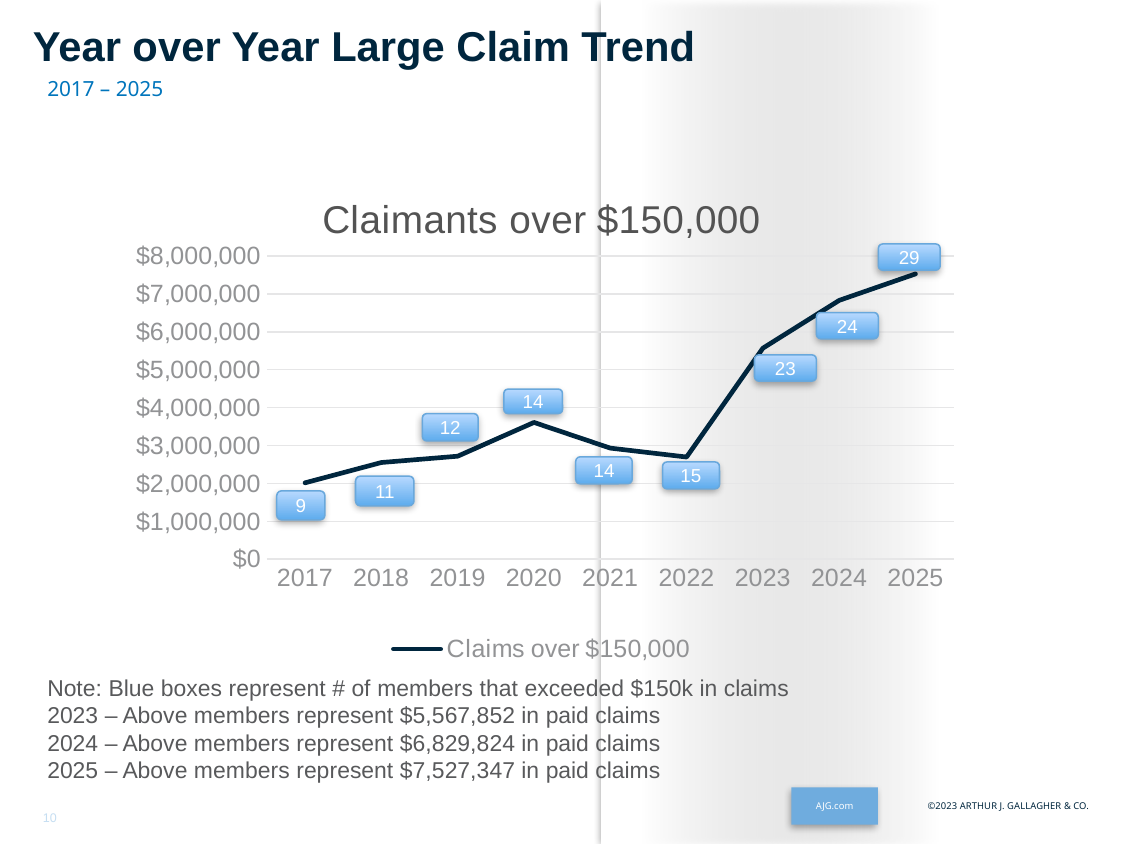
How many years are plotted on the x axis of the chart? 9 Which year has the lowest value for claims over $150,000? 2017 Which year has the highest value for claims over $150,000? 2025 How many series does the chart legend list? 1 According to the blue box, how many members exceeded $150k in claims in 2022? 15 What is the title of the chart? Claimants over $150,000 What type of chart is shown on the slide? line chart According to the blue box, how many members exceeded $150k in claims in 2017? 9 Is the value for claims over $150,000 in 2020 greater or less than $3,000,000? greater Is the value for claims over $150,000 in 2022 greater or less than $3,000,000? less According to the blue box, how many members exceeded $150k in claims in 2025? 29 Do the claims over $150,000 rise or fall from 2022 to 2025? rise